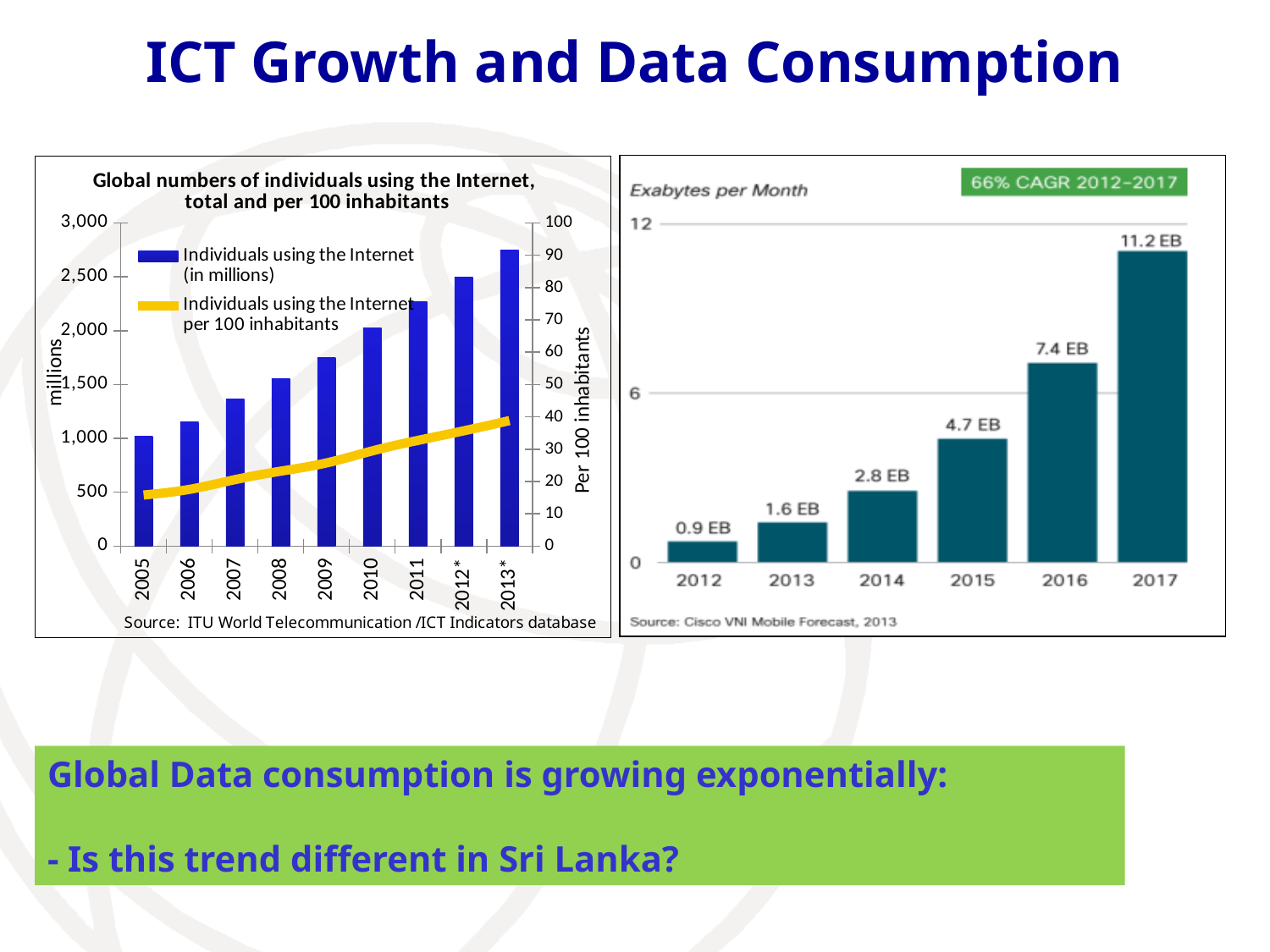
In the Exabytes per Month chart, which year has the lowest value? 2012 In the chart on the left, is the number of individuals using the Internet (in millions) for 2013* greater or less than 2,500? greater In the Exabytes per Month chart, which year has the highest value? 2017 In the chart on the left, how many series does the legend list? 2 What CAGR is stated in the green label on the Exabytes per Month chart? 66% CAGR 2012-2017 In the Exabytes per Month chart, do the values rise or fall from 2012 to 2017? rise In the Exabytes per Month chart, how many years are shown on the x axis? 6 In the chart on the left, is the number of individuals using the Internet (in millions) for 2007 greater or less than 1,500? less In the Exabytes per Month chart, what is the value for 2017? 11.2 EB In the Exabytes per Month chart, what is the difference between the 2016 and 2015 values? 2.7 EB In the Exabytes per Month chart, what is the value for 2014? 2.8 EB In the chart on the left, how many years are shown on the x axis? 9